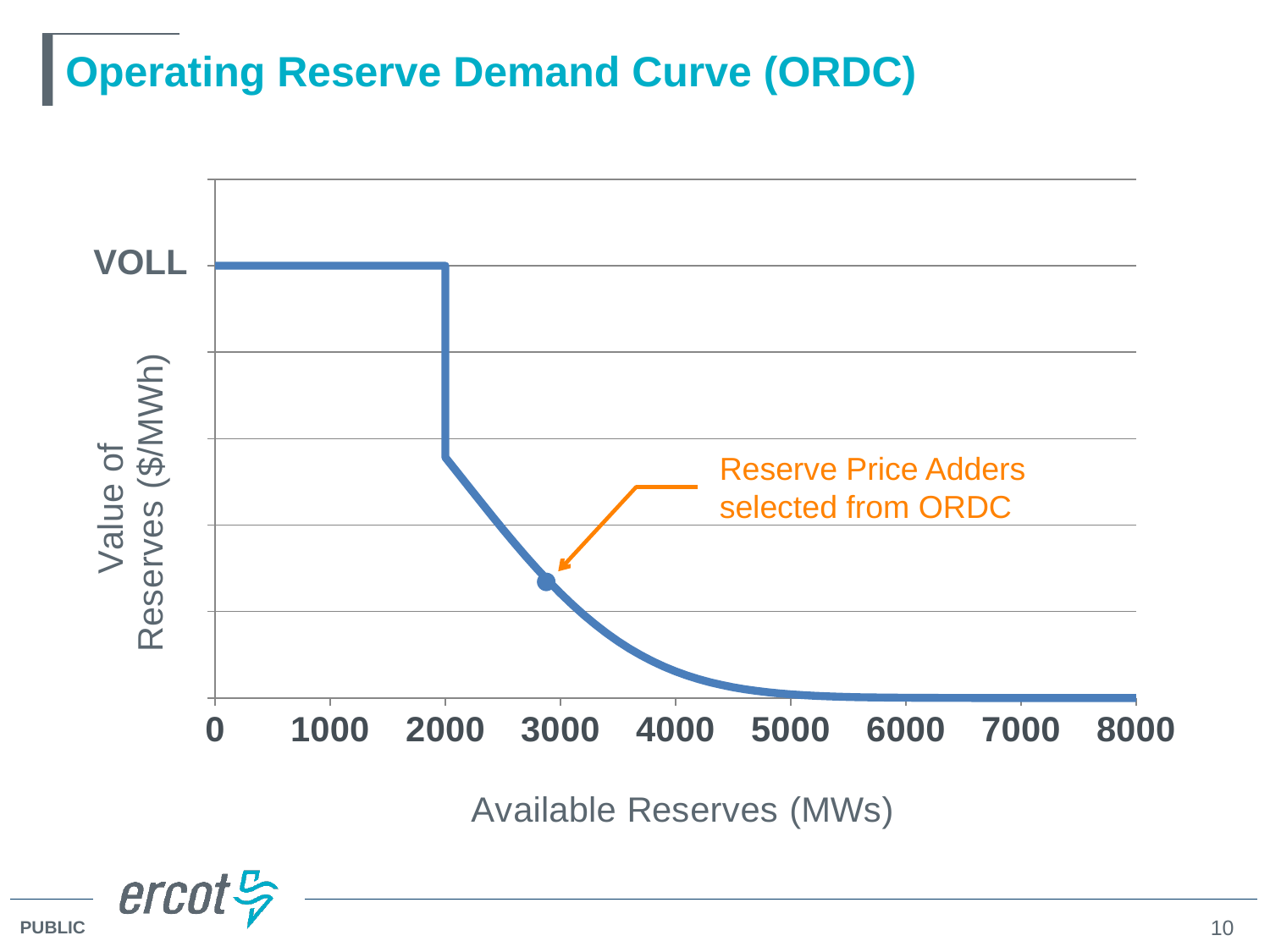
What kind of chart is shown on the slide? line chart Does the value of reserves rise or fall as available reserves increase along the x axis? fall Which is larger: the value of reserves at 3000 MW or at 6000 MW? 3000 MW What is the largest value shown on the x axis? 8000 What does the orange annotation pointing to the dot on the curve say? Reserve Price Adders selected from ORDC How many tick labels are shown on the x axis? 9 At what level of available reserves (MWs) does the curve drop sharply from VOLL? 2000 At which end of the x axis is the value of reserves highest, 0 MW or 8000 MW? 0 MW What is the label on the x axis? Available Reserves (MWs) What is the value of reserves when available reserves are 1000 MW? VOLL Which is larger: the value of reserves at 1000 MW or at 4000 MW? 1000 MW